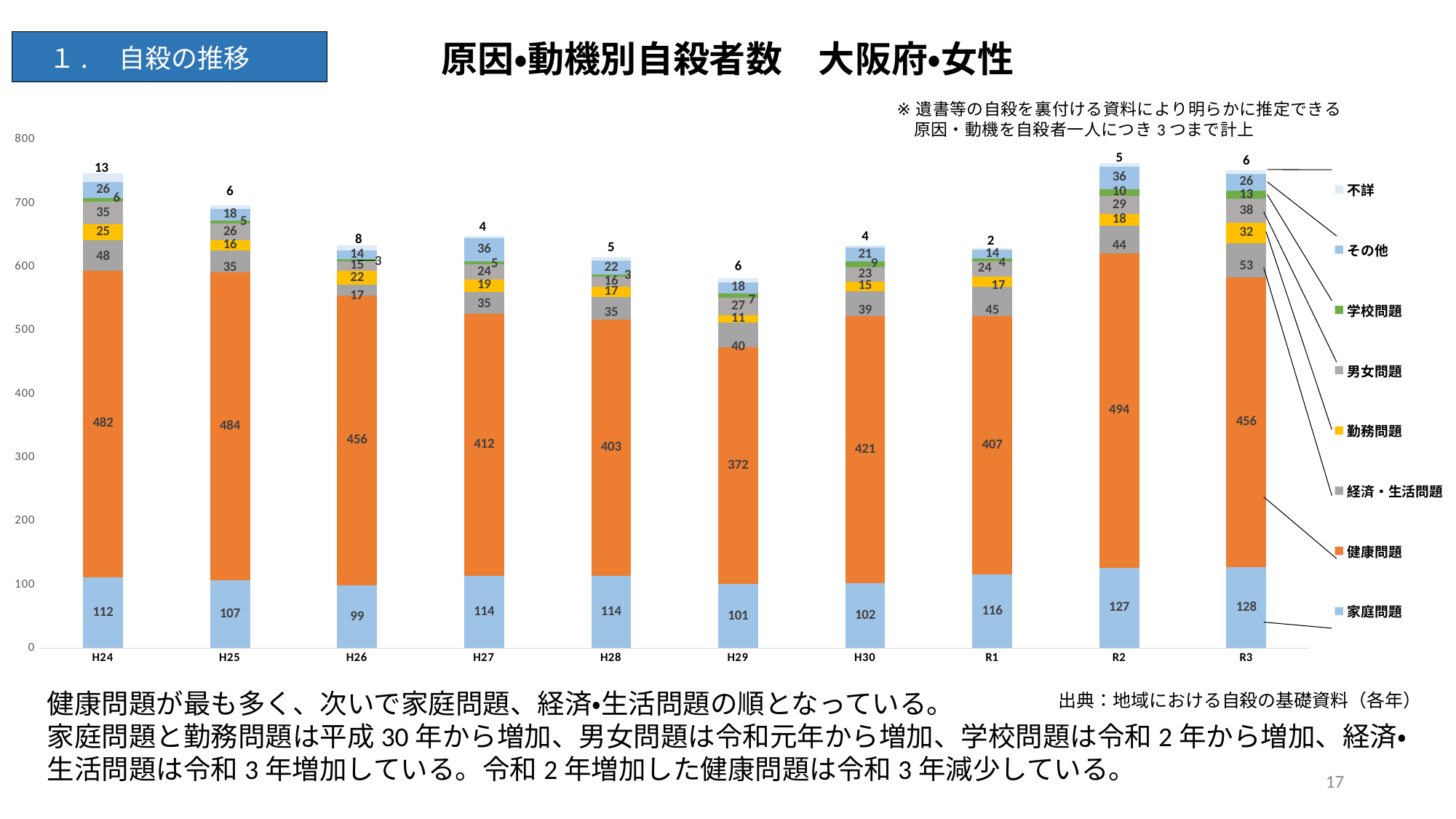
How many series does the legend list? 8 What is the difference between the 健康問題 values for R2 and R3? 38 Which year has the larger 家庭問題 value, H24 or H25? H24 In which year is the 健康問題 value the highest? R2 What is the value of 勤務問題 for R3? 32 How many years are shown on the x axis? 10 What is the value of 家庭問題 for R3? 128 What is the value of 健康問題 for H24? 482 Does the 家庭問題 value rise or fall from H30 to R3? Rise What kind of chart is shown? Stacked bar chart What is the total of the stacked bar for H24? 747 In which year is the 健康問題 value the lowest? H29